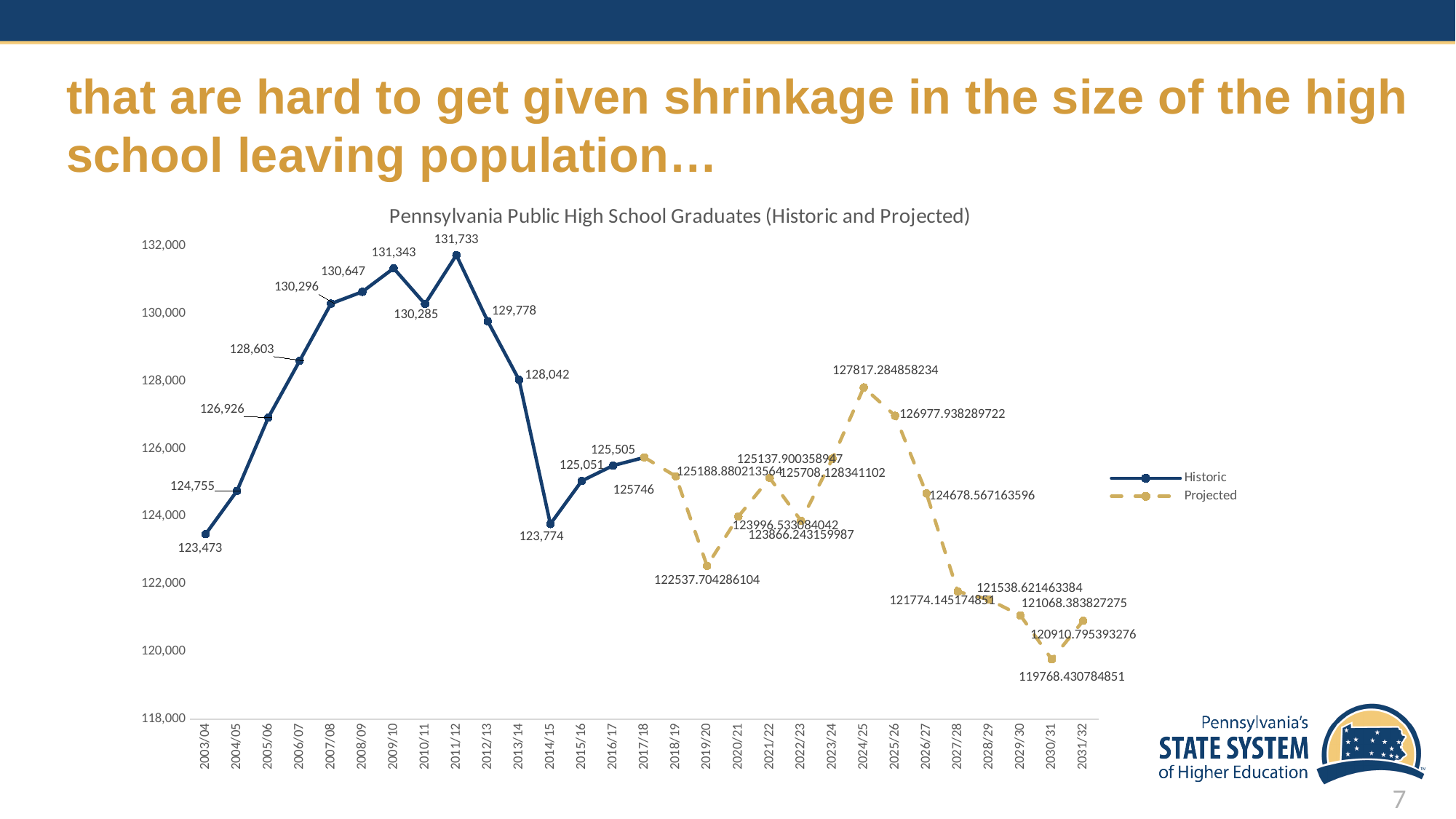
What is the Historic value for 2014/15? 123,774 How many series does the legend list? 2 What type of chart is shown on the slide? Line chart What is the difference between the Historic values for 2011/12 and 2003/04? 8,260 How many school years are shown on the x axis? 29 Is the Projected value for 2019/20 greater or less than 124,000? less What is the Projected value for 2024/25? 127817.284858234 Which year has the lowest Projected value? 2030/31 Which is larger, the Historic value for 2009/10 or for 2010/11? 2009/10 What is the Historic value for 2011/12? 131,733 Which year has the highest Historic value? 2011/12 What is the title of the chart? Pennsylvania Public High School Graduates (Historic and Projected)